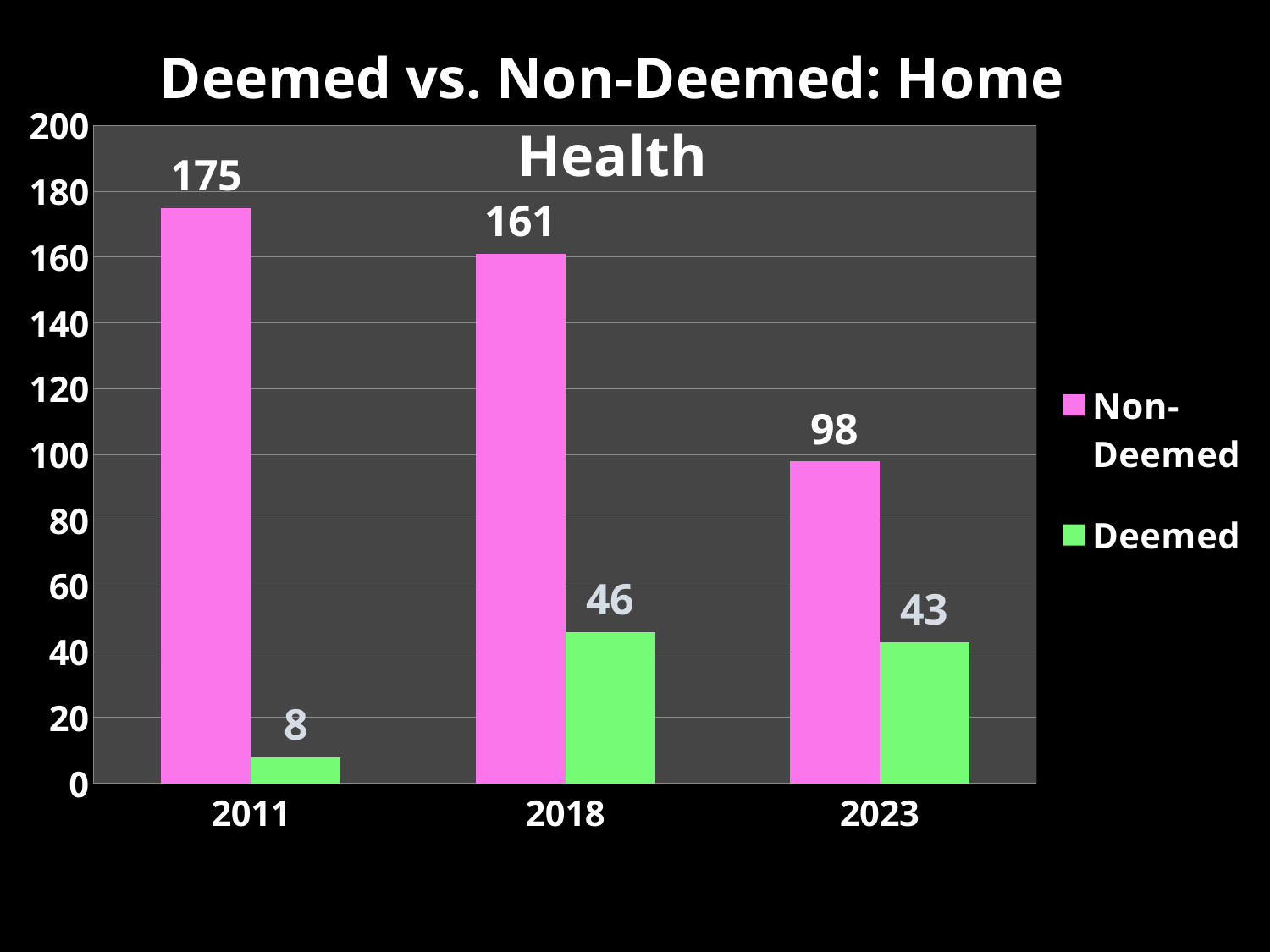
What kind of chart is shown on the slide? Bar chart What is the difference between the Non-Deemed and Deemed values in 2023? 55 What is the Non-Deemed value for 2011? 175 In which year is the Non-Deemed value highest? 2011 What is the Deemed value for 2011? 8 Do the Non-Deemed values rise or fall from 2011 to 2023? Fall In which year is the Deemed value lowest? 2011 What is the Non-Deemed value for 2023? 98 How many series does the legend list? 2 Which is larger in 2018, the Non-Deemed value or the Deemed value? Non-Deemed What is the Deemed value for 2018? 46 How many years are shown on the x axis? 3